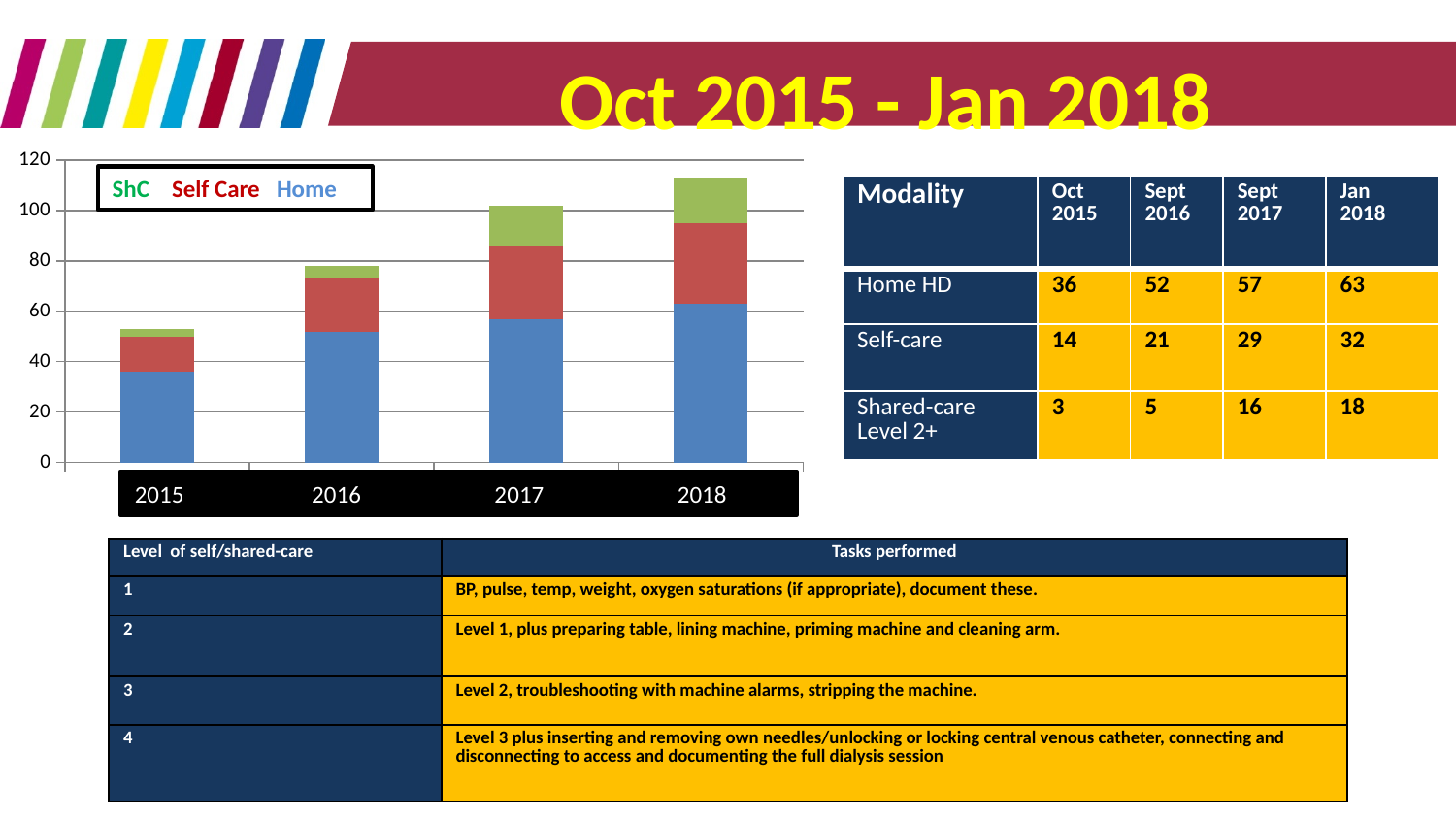
Is the Home (blue) segment larger in 2015 or in 2018? 2018 Which year has the tallest stacked bar? 2018 Is the total bar height for 2017 greater or less than 80? greater What are the three legend entries of the bar chart? ShC, Self Care, Home Which year has the shortest stacked bar? 2015 Is the total bar height for 2015 greater or less than 60? less Do the total bar heights rise or fall from 2015 to 2018? rise Is the total bar height for 2018 greater or less than 100? greater How many series does the bar chart's legend list? 3 What kind of chart is shown on the left of the slide? bar chart Which colour represents the Home series in the bar chart? blue How many years are shown on the x axis of the bar chart? 4